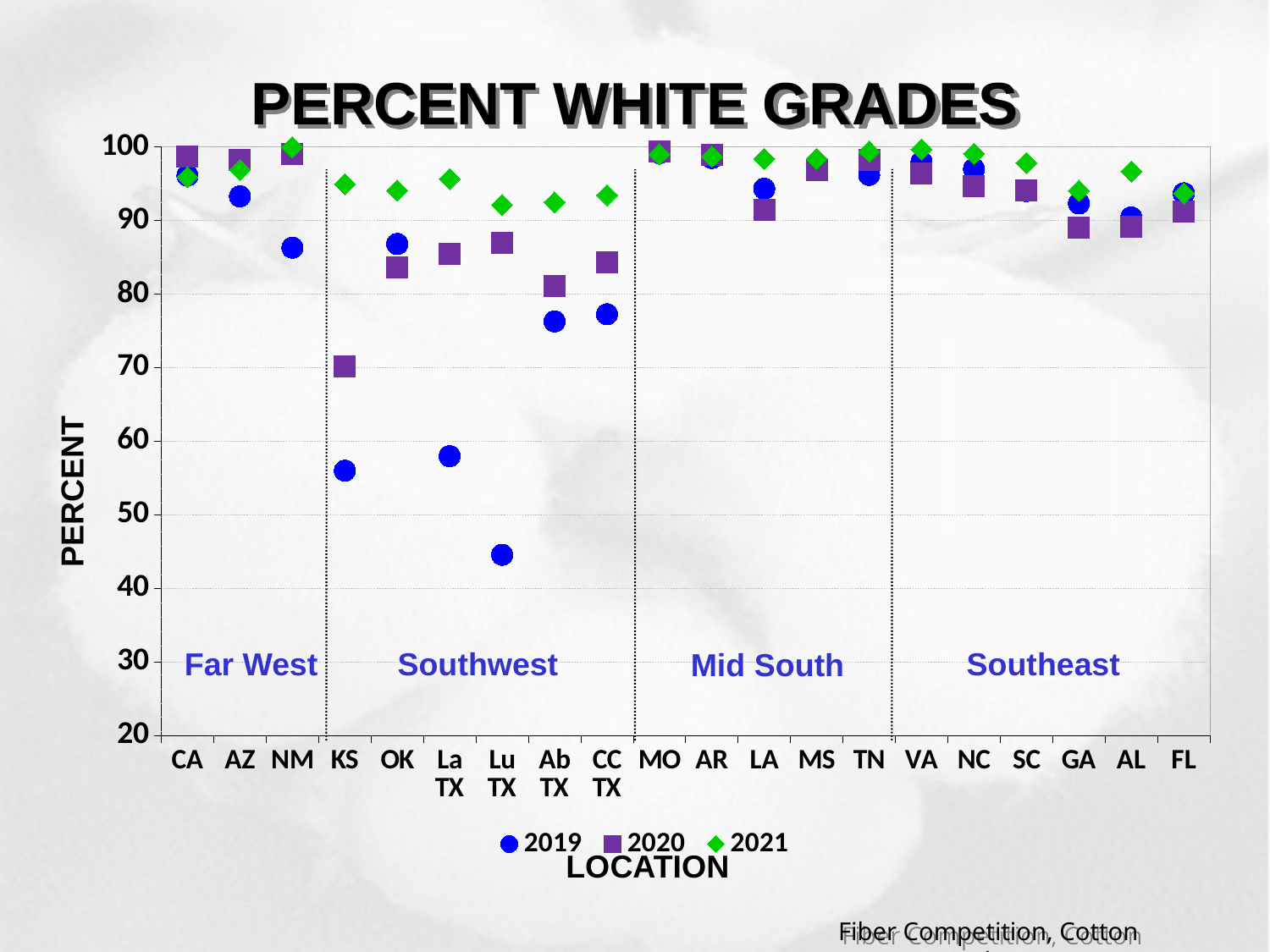
Is the 2019 value for Lu TX greater or less than 50? less Which location has the lowest 2020 value? KS Is the 2020 value for KS greater or less than 80? less How many series does the legend list? 3 What is the title of the chart? PERCENT WHITE GRADES What kind of chart is shown on the slide? scatter chart How many locations are plotted along the x axis? 20 At KS, which series has the larger value, 2019 or 2020? 2020 Is the 2019 value for KS greater or less than 60? less Which location has the lowest 2019 value? Lu TX